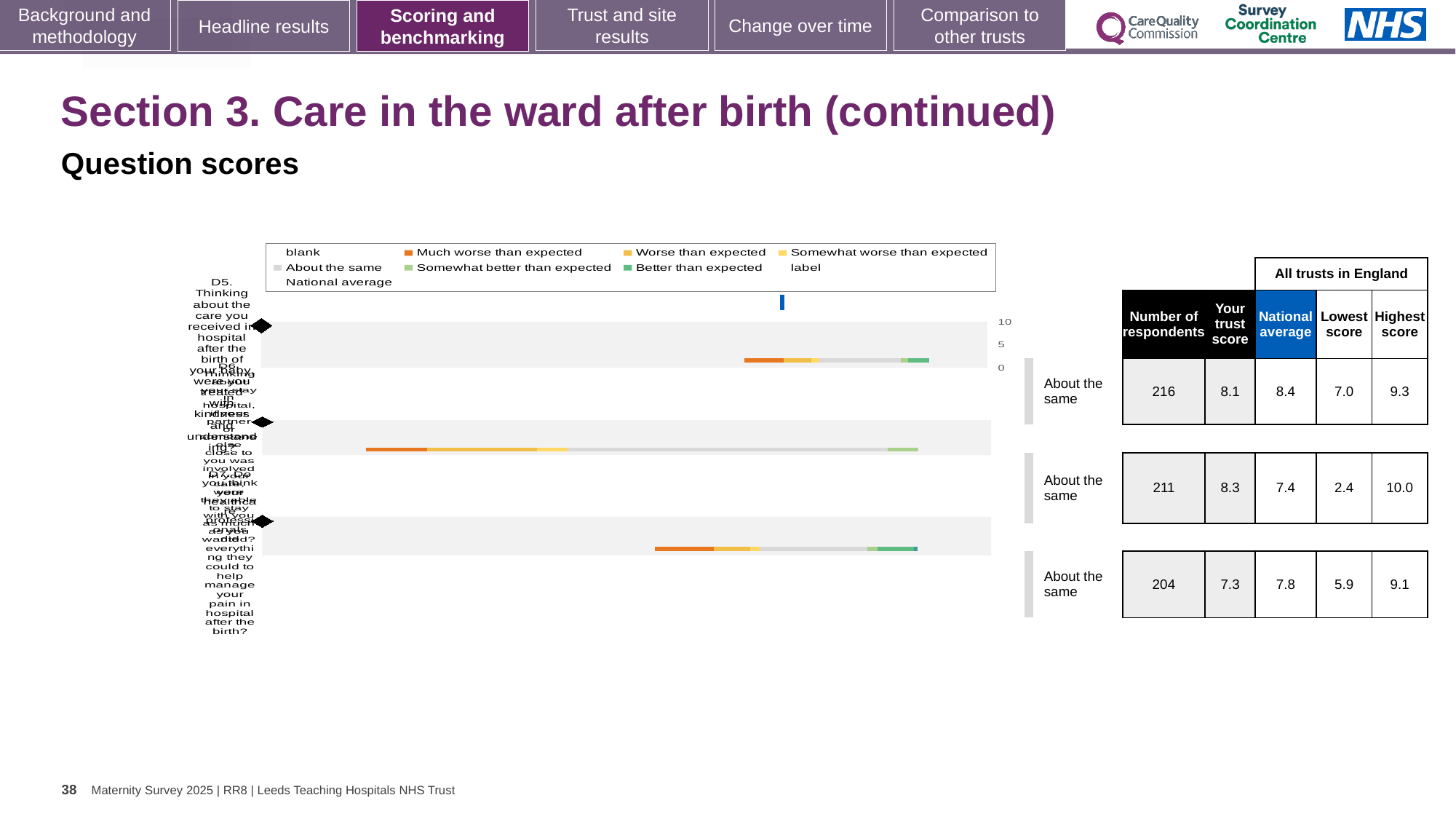
What kind of chart is shown on the slide? bar chart How many horizontal bars does the chart contain? 3 In the table to the right of the chart, which row has the lowest 'Lowest score' value? the second row (2.4) What is the highest tick value shown on the chart's axis? 10 In the table to the right of the chart, what is the number of respondents for the first row? 216 In the table to the right of the chart, what is the difference between the national average and the trust score in the first row? 0.3 In the table to the right of the chart, is the trust score in the second row larger or smaller than the national average in that row? larger In the table to the right of the chart, what is the 'Your trust score' for the second row? 8.3 What colour does the legend use for 'Much worse than expected'? orange In the table to the right of the chart, which row has the highest 'Highest score' value? the second row (10.0) In the table to the right of the chart, what is the national average for the third row? 7.8 What benchmark label is shown for each of the three rows next to the chart? About the same